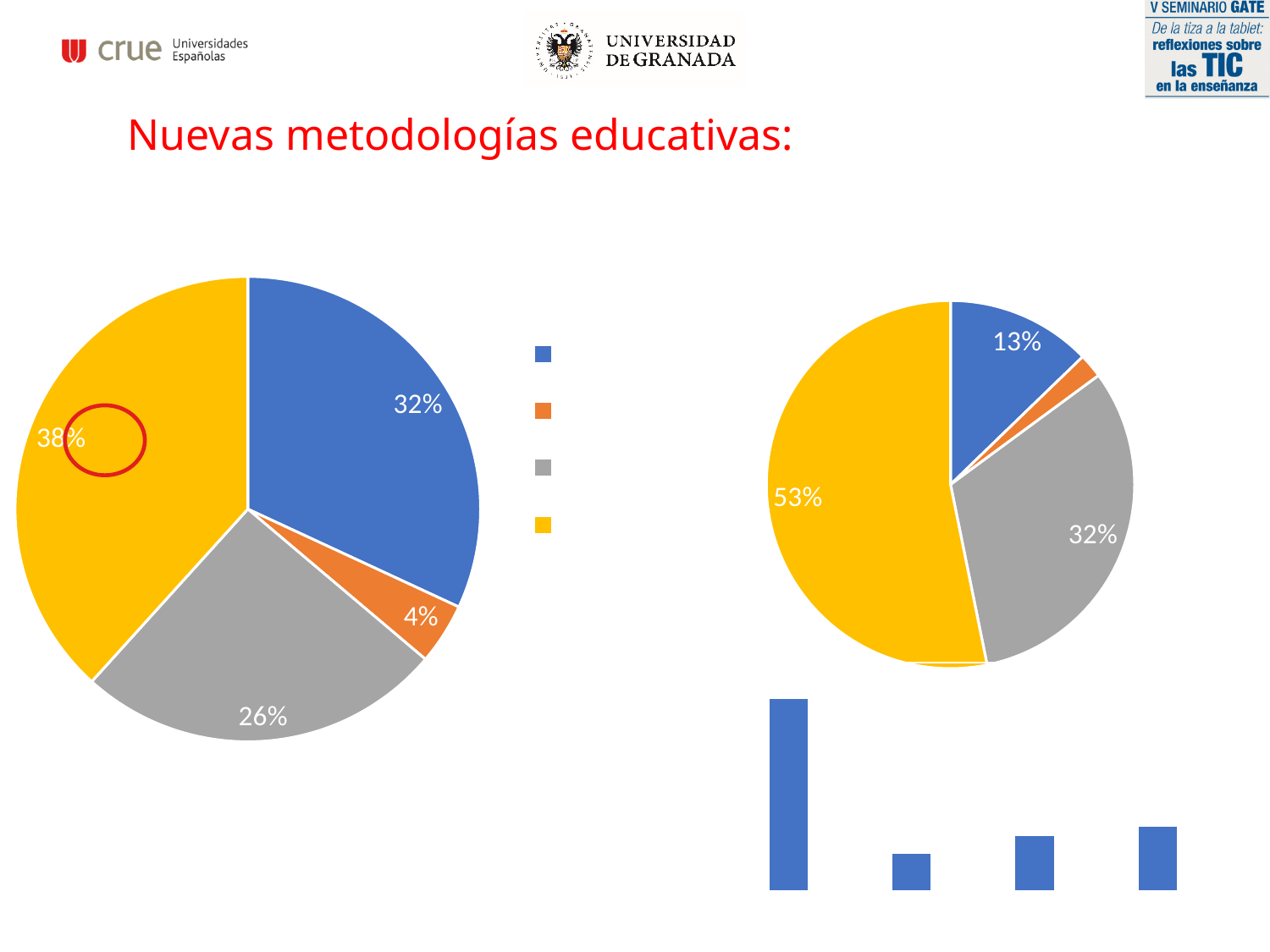
In the left pie chart, what percentage is shown on the yellow slice? 38% In the right pie chart, which is larger, the gray slice or the blue slice? gray slice In the left pie chart, what percentage is shown on the blue slice? 32% In the left pie chart, what is the difference between the blue slice and the gray slice? 6% In the bar chart at the bottom right of the slide, which bar is the tallest? the first (leftmost) bar In the left pie chart, which colour slice is the smallest? orange In the right pie chart, what percentage is shown on the yellow slice? 53% In the right pie chart, what percentage is shown on the blue slice? 13% In the left pie chart, what percentage is shown on the orange slice? 4% In the left pie chart, which colour slice is the largest? yellow What kind of chart is the chart on the left of the slide? pie chart How many bars does the bar chart at the bottom right of the slide have? 4